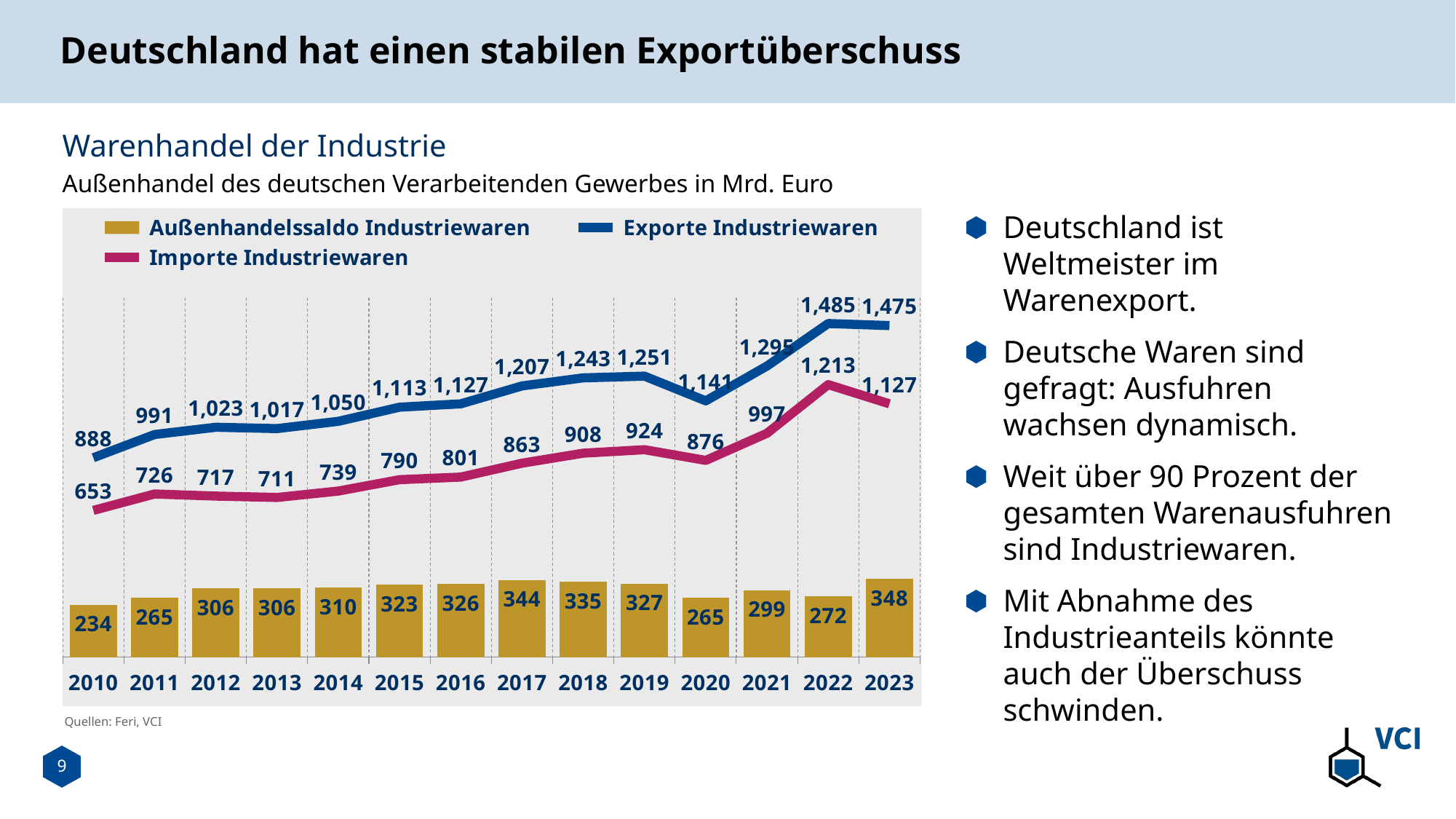
In which year is the Außenhandelssaldo Industriewaren lowest? 2010 How many series does the legend list? 3 Do Exporte Industriewaren rise or fall from 2010 to 2019? Rise In which year are Exporte Industriewaren highest? 2022 What is the value of Exporte Industriewaren in 2022? 1,485 Which is larger: Importe Industriewaren in 2022 or in 2023? 2022 In which year is the Außenhandelssaldo Industriewaren highest? 2023 What is the difference between Exporte Industriewaren and Importe Industriewaren in 2023? 348 What is the Außenhandelssaldo Industriewaren in 2020? 265 What kind of chart is this? Combined bar and line chart How many years are shown on the x axis? 14 What is the value of Importe Industriewaren in 2010? 653